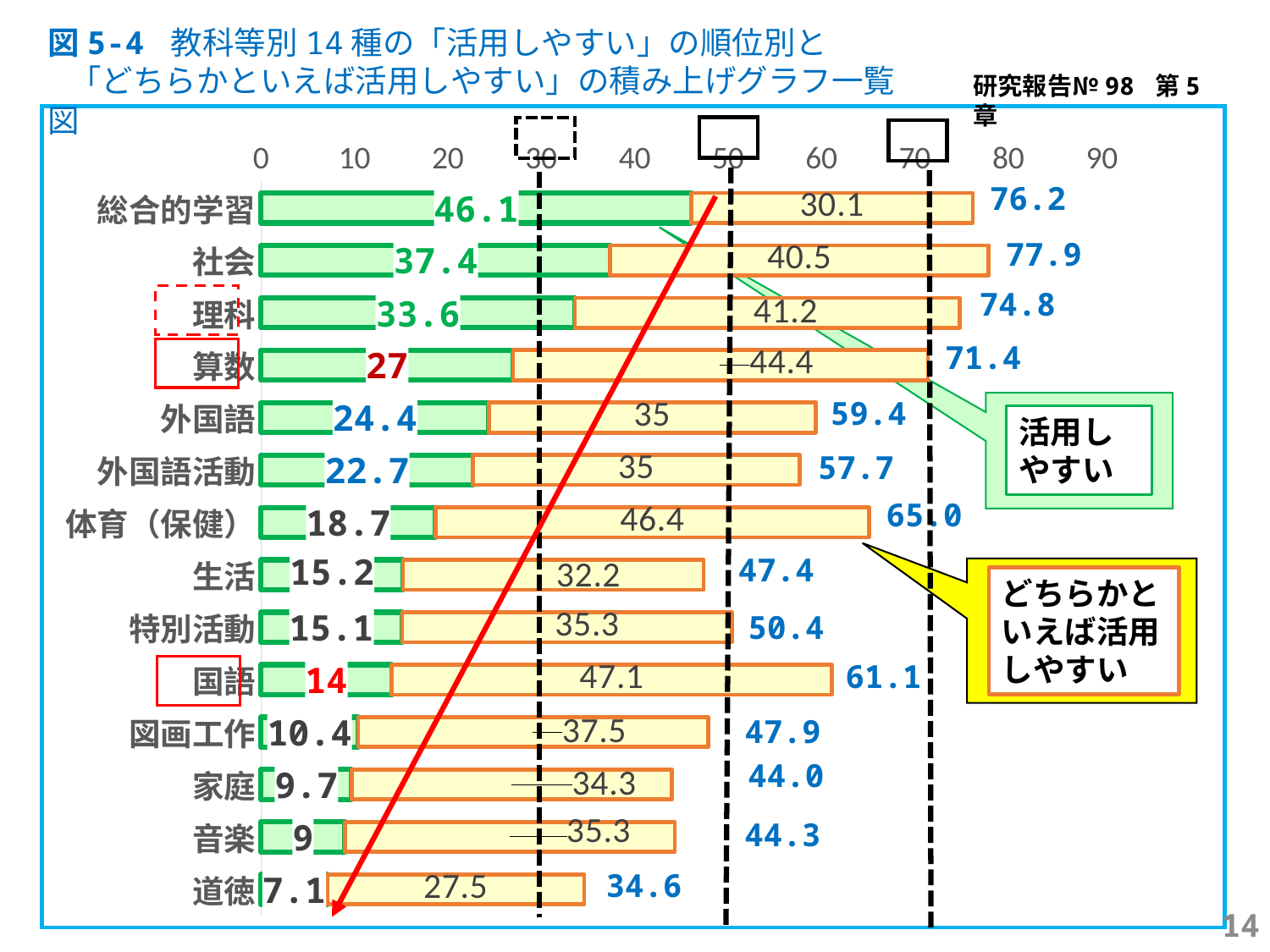
Which is larger, the どちらかといえば活用しやすい value for 国語 or for 生活? 国語 What is the どちらかといえば活用しやすい value for 体育（保健）? 46.4 Which subject has the lowest 活用しやすい value? 道徳 What kind of chart is shown on the slide? Stacked bar chart Which subject has the highest 活用しやすい value? 総合的学習 Do the 活用しやすい values rise or fall going down the list from 総合的学習 to 道徳? Fall How many series are stacked in each bar? 2 What is the 活用しやすい value for 社会? 37.4 How many subjects are shown in the chart? 14 What is the total printed at the end of the bar for 算数? 71.4 Which subject has the highest total (活用しやすい plus どちらかといえば活用しやすい)? 社会 What is the difference between the 活用しやすい values for 総合的学習 and 理科? 12.5